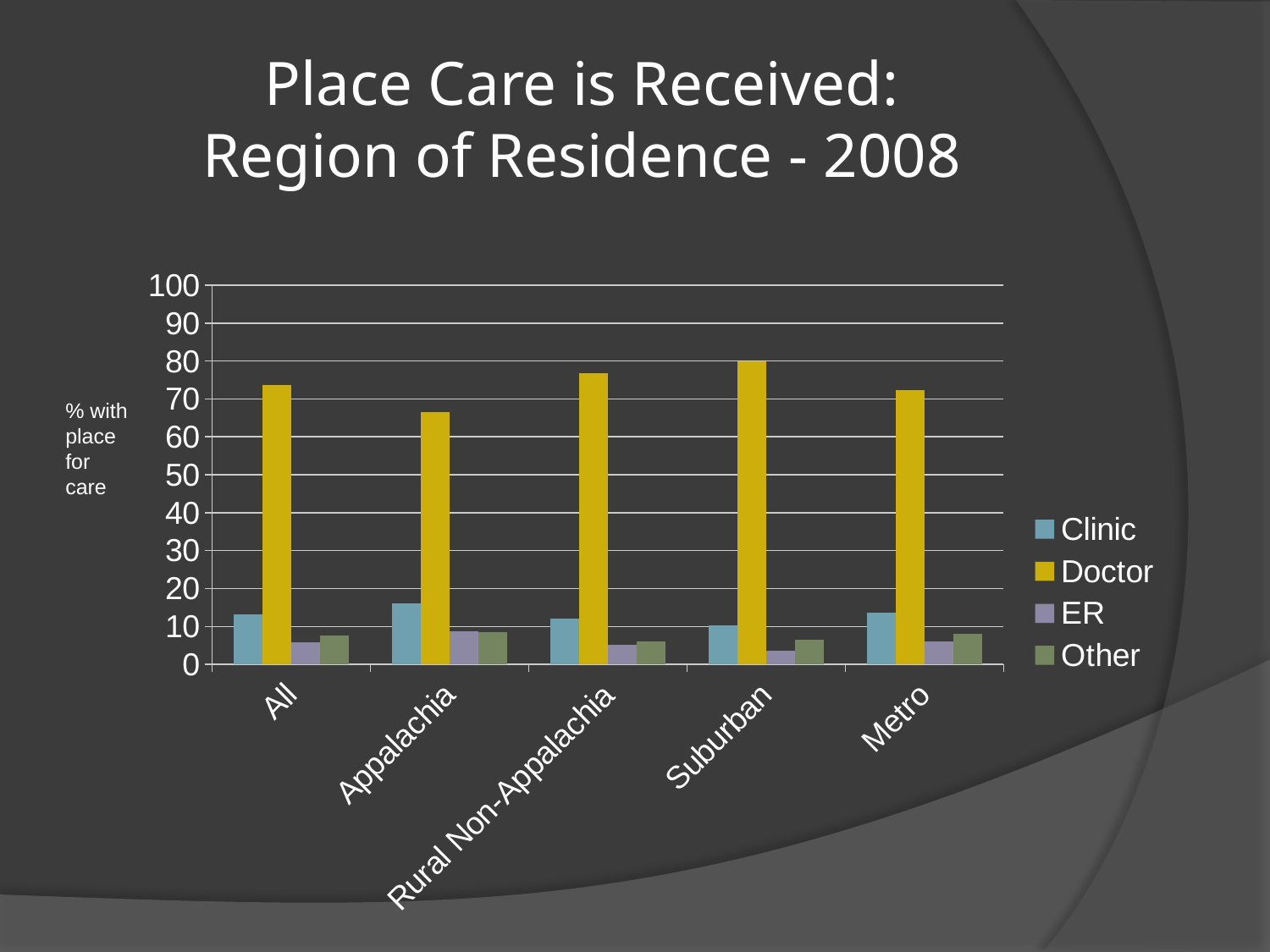
Is the Clinic value for Appalachia greater or less than 10? greater How many region categories are shown on the x axis? 5 Is the Doctor value for Rural Non-Appalachia greater or less than 70? greater What kind of chart is shown on the slide? bar chart Is the Doctor value for Appalachia greater or less than 70? less Which region has the highest Doctor value? Suburban Which region has the lowest Doctor value? Appalachia Which is larger, the Doctor value for Appalachia or the Doctor value for Metro? Metro How many series does the legend list? 4 Which region has the highest Clinic value? Appalachia What colour represents the Doctor series in the legend? yellow